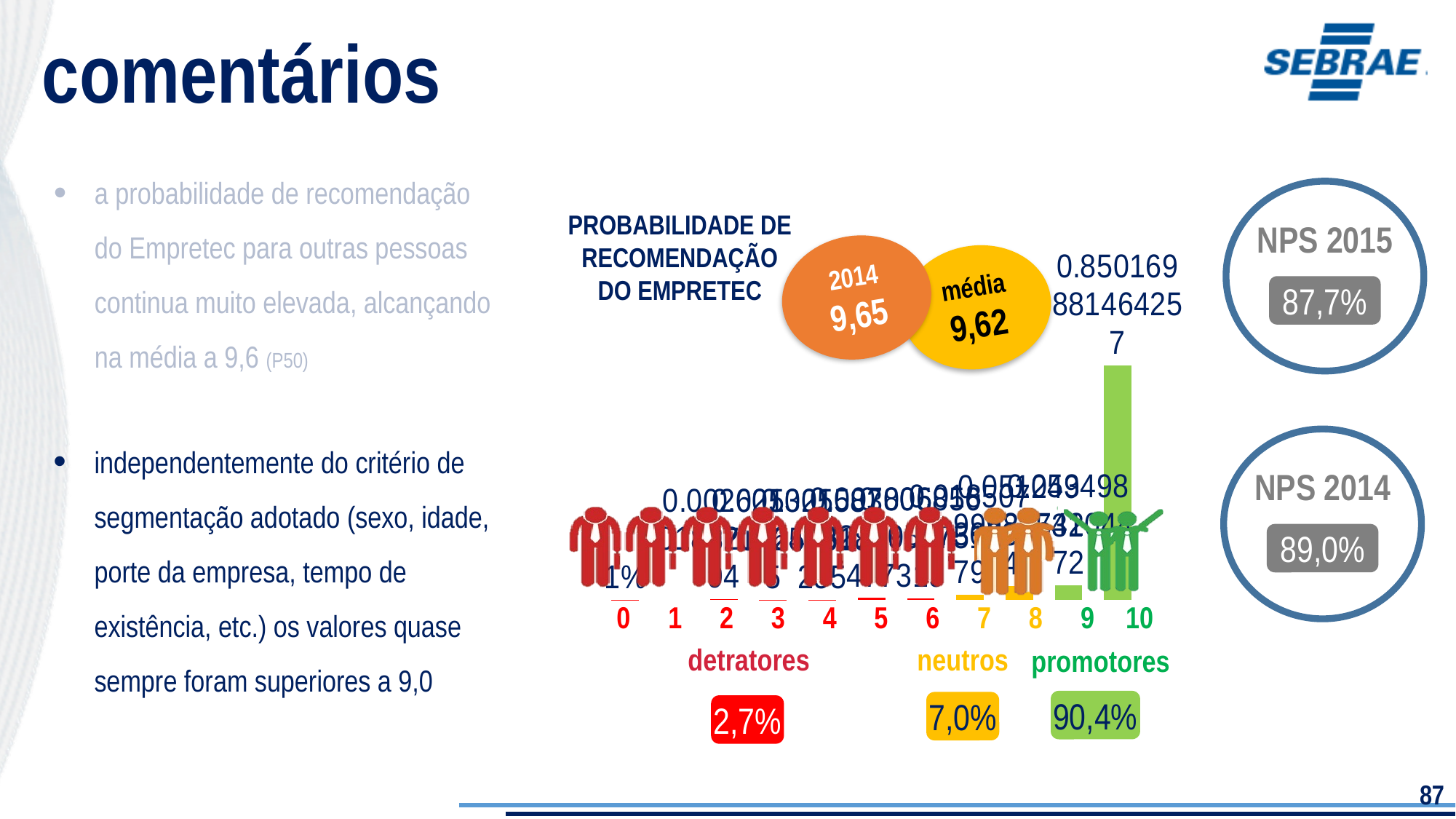
What is the 2014 value shown in the orange circle above the chart? 9,65 Which bar is taller, the one for score 9 or the one for score 10? 10 What percentage is shown for the 'promotores' group below the chart? 90,4% What percentage is shown for the 'neutros' group below the chart? 7,0% What percentage is shown for the 'detratores' group below the chart? 2,7% What is the data label printed above the bar for score 10? 0.850169881464257 What is the 'média' value shown in the yellow circle above the chart? 9,62 What kind of chart is used to show the probability of recommending Empretec by score? bar chart Which score categories on the x axis are labelled in green as 'promotores'? 9 and 10 Which score category has the tallest bar in the chart? 10 How many score categories are shown on the x axis of the chart? 11 What is the title of the chart? PROBABILIDADE DE RECOMENDAÇÃO DO EMPRETEC